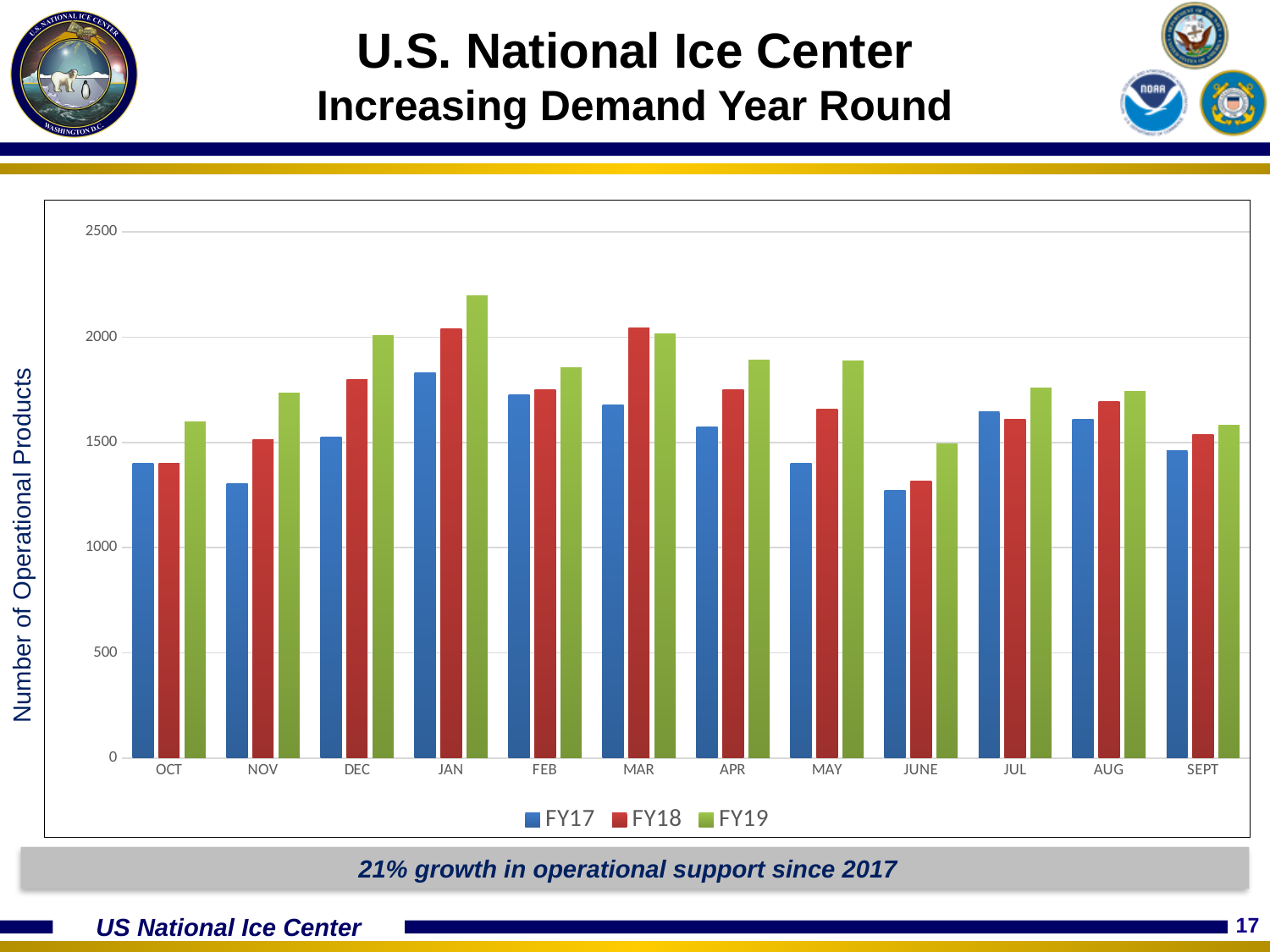
What is the label on the vertical axis of the chart? Number of Operational Products Which month has the lowest FY18 value? JUNE Which month has the highest FY19 value? JAN Is the FY18 value for MAR greater or less than 2000? greater How many series does the legend list? 3 What kind of chart is shown on the slide? bar chart In MAY, which is larger: the FY17 value or the FY19 value? FY19 How many months are shown along the x axis? 12 Is the FY17 value for JUNE greater or less than 1500? less Which month has the lowest FY19 value? JUNE Is the FY19 value for JAN greater or less than 2000? greater In DEC, which is larger: the FY17 value or the FY18 value? FY18